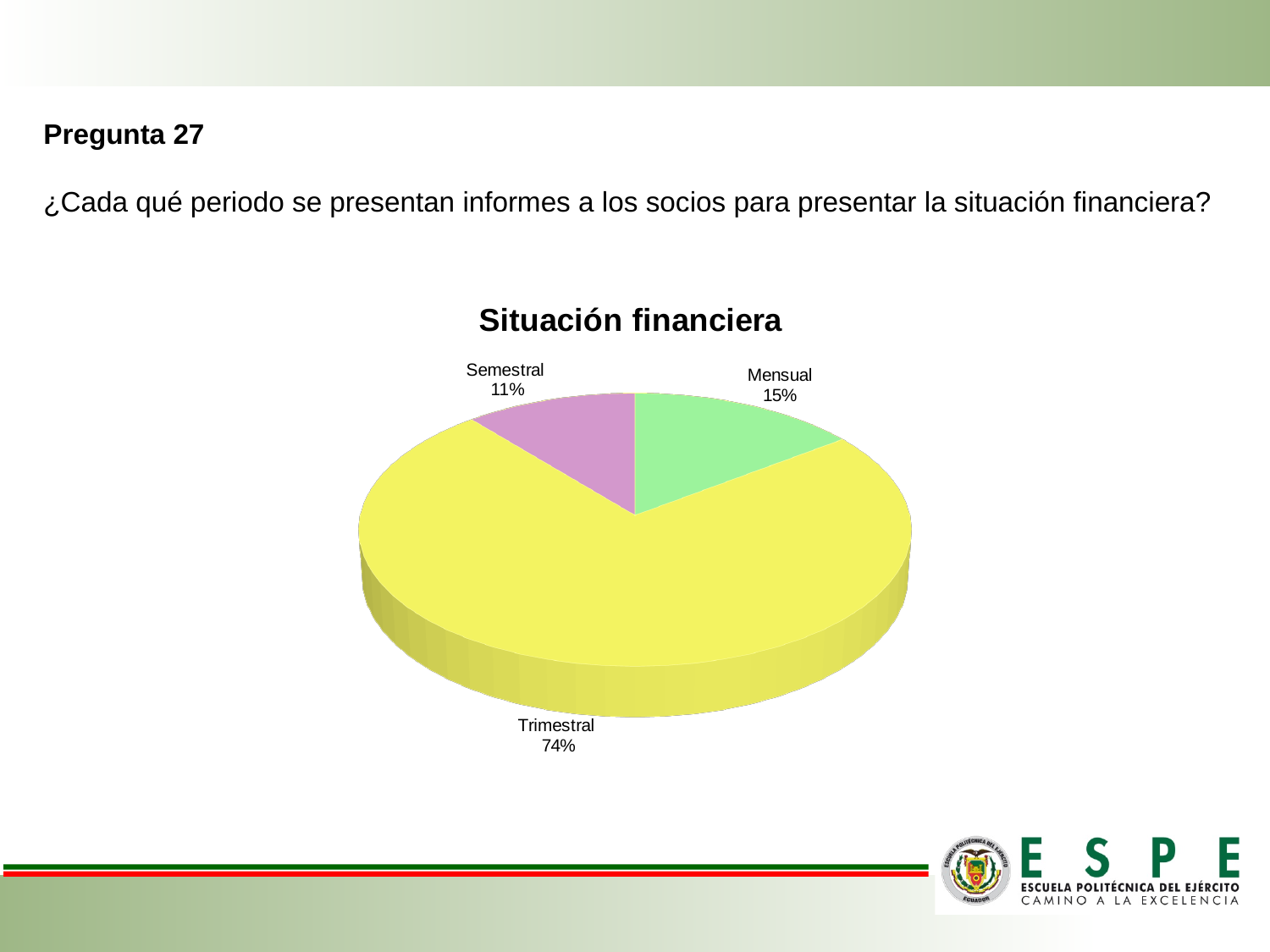
Which category has the smallest slice of the pie? Semestral What kind of chart is shown on the slide? Pie chart What is the difference between the Trimestral and Mensual percentages? 59% What share of the pie does Trimestral represent? 74% How many categories are shown in the pie chart? 3 What is the title of the chart? Situación financiera What is the difference between the Mensual and Semestral percentages? 4% Which category has the largest slice of the pie? Trimestral What is the value shown for Semestral? 11% What colour is the Trimestral slice? Yellow Which is larger, the Mensual slice or the Semestral slice? Mensual What is the value shown for Mensual? 15%